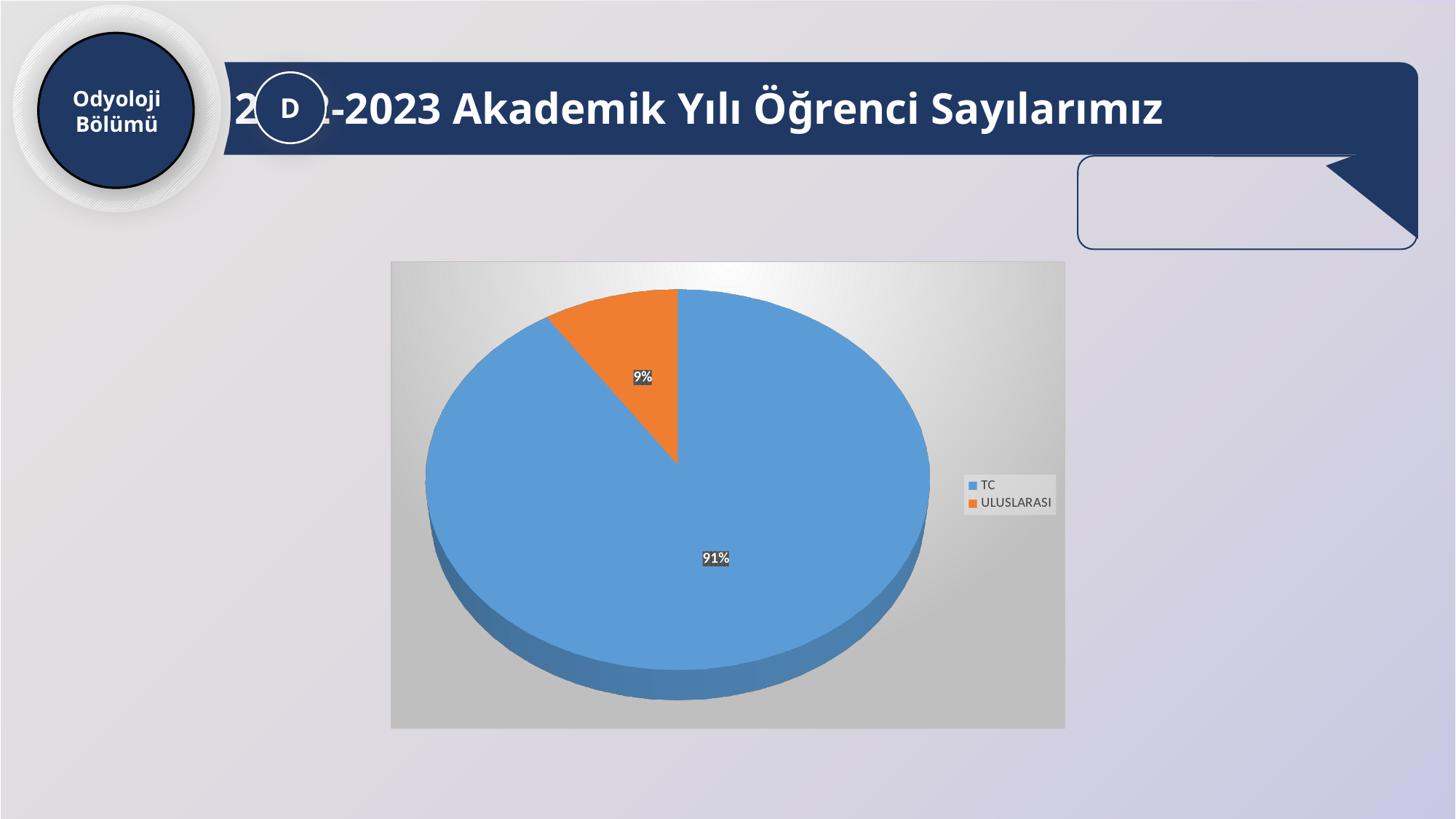
How many entries does the legend list? 2 What share of the pie does TC represent? 91% Which category has the largest slice of the pie? TC What colour is the slice for ULUSLARASI? orange What share of the pie does ULUSLARASI represent? 9% What is the difference in percentage points between the TC share and the ULUSLARASI share? 82 What colour is the slice for TC? blue Which category has the smallest slice of the pie? ULUSLARASI How many slices does the pie chart have? 2 What kind of chart is shown on the slide? pie chart Which is larger, the share for TC or the share for ULUSLARASI? TC